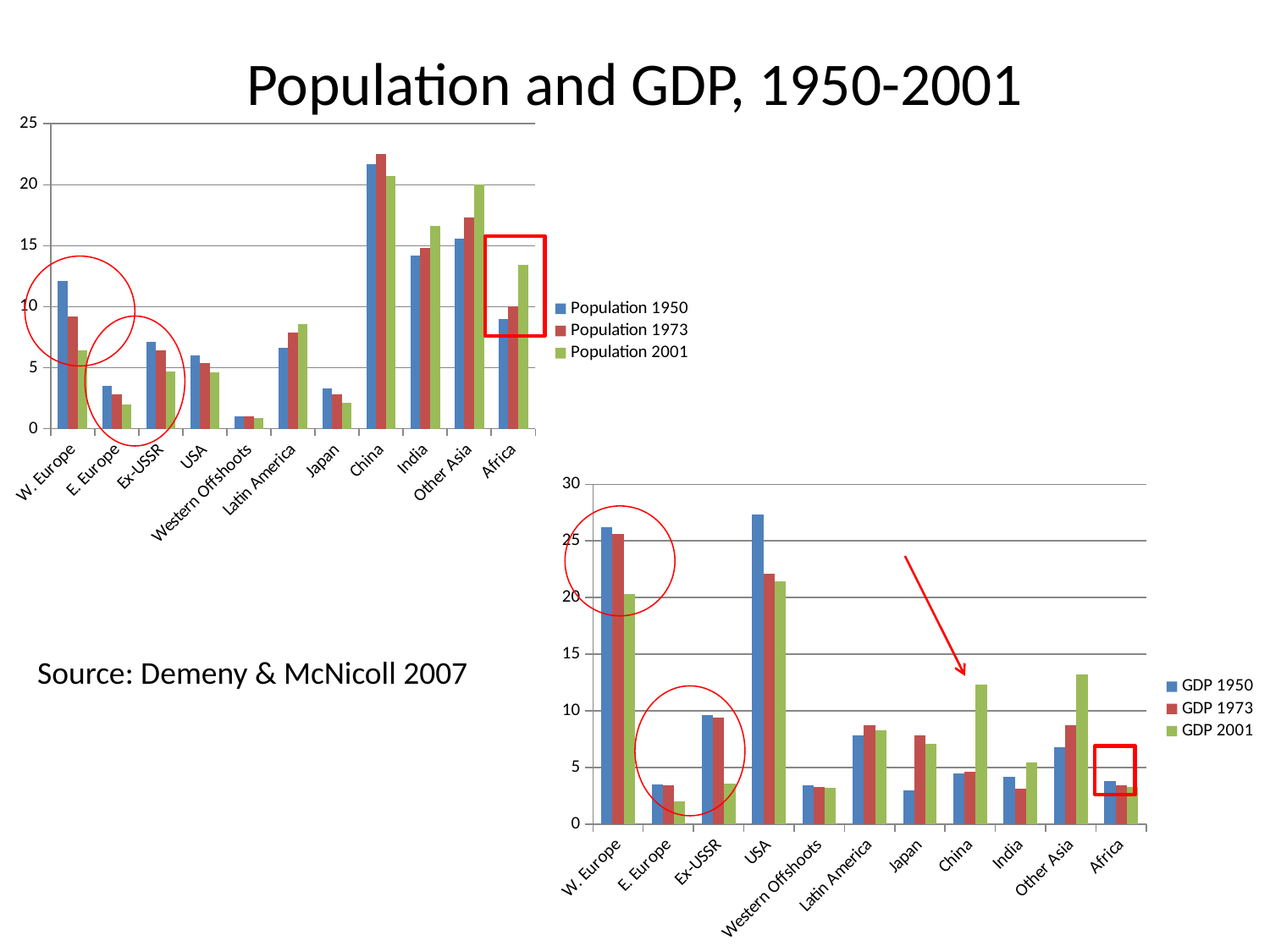
On the population chart (top left), which region has the highest Population 1950 value? China On the population chart (top left), which region has the lowest Population 1950 value? Western Offshoots On the population chart (top left), how many series does the legend list? 3 On the GDP chart (bottom right), which is larger for Japan: GDP 1950 or GDP 1973? GDP 1973 On the population chart (top left), is the Population 2001 value for Africa greater or less than 10? greater What kind of chart is the GDP chart (bottom right)? bar chart On the GDP chart (bottom right), which region has the lowest GDP 2001 value? E. Europe On the population chart (top left), do the values for W. Europe rise or fall from Population 1950 to Population 2001? fall On the GDP chart (bottom right), is the GDP 2001 value for China greater or less than 10? greater On the population chart (top left), is the Population 1950 value for W. Europe greater or less than 10? greater On the GDP chart (bottom right), which region has the highest GDP 1973 value? W. Europe On the population chart (top left), how many regions are shown on the x axis? 11